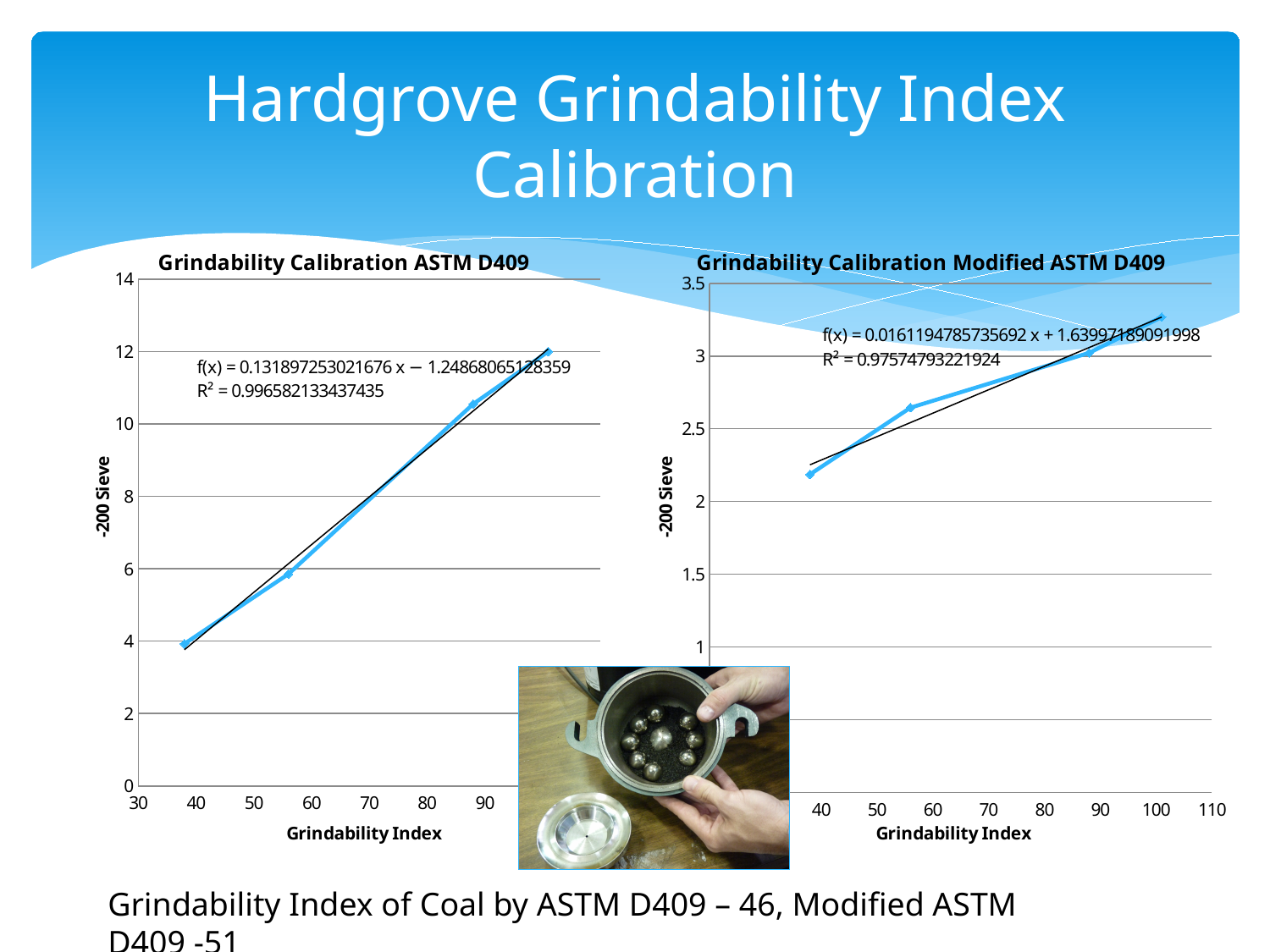
How many data points are plotted on the 'Grindability Calibration ASTM D409' chart? 4 What kind of chart is the 'Grindability Calibration ASTM D409' chart? line chart On the 'Grindability Calibration Modified ASTM D409' chart, is the -200 Sieve value of the leftmost data point greater or less than 2.5? less What R² value is shown on the 'Grindability Calibration Modified ASTM D409' chart? 0.97574793221924 On the 'Grindability Calibration ASTM D409' chart, is the -200 Sieve value of the rightmost data point greater or less than 10? greater How many data points are plotted on the 'Grindability Calibration Modified ASTM D409' chart? 4 On the 'Grindability Calibration ASTM D409' chart, do the -200 Sieve values rise or fall as the Grindability Index increases? rise On the 'Grindability Calibration ASTM D409' chart, is the -200 Sieve value of the leftmost data point greater or less than 6? less What R² value is shown on the 'Grindability Calibration ASTM D409' chart? 0.996582133437435 On the 'Grindability Calibration Modified ASTM D409' chart, do the -200 Sieve values rise or fall as the Grindability Index increases? rise On the 'Grindability Calibration Modified ASTM D409' chart, which data point has the highest -200 Sieve value, the leftmost or the rightmost? rightmost